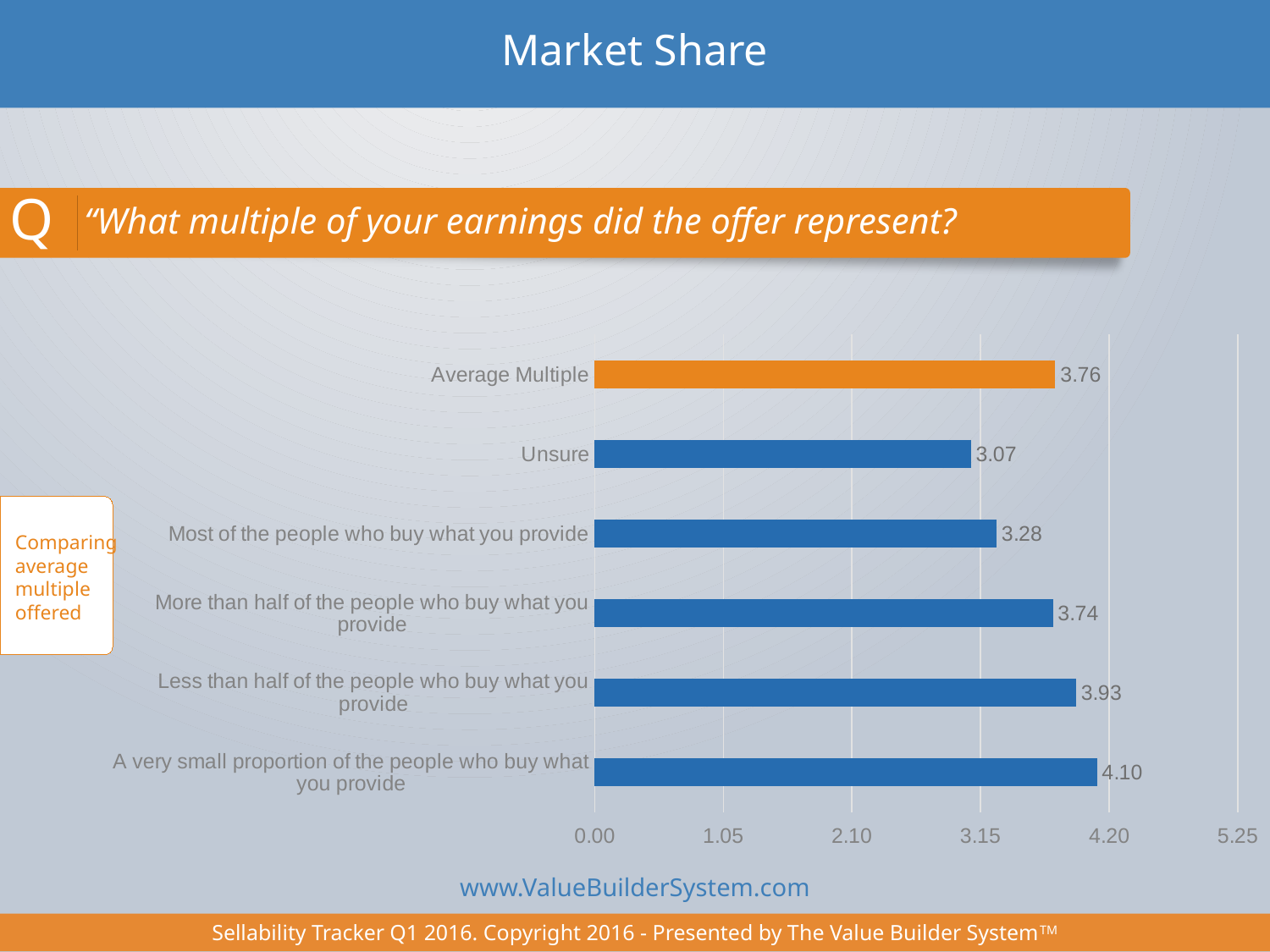
Which is larger: the value for 'Most of the people who buy what you provide' or 'More than half of the people who buy what you provide'? More than half of the people who buy what you provide What is the value for 'A very small proportion of the people who buy what you provide'? 4.10 How many categories are shown in the chart? 6 Which category has the lowest value? Unsure What kind of chart is shown on the slide? bar chart What is the value for 'Less than half of the people who buy what you provide'? 3.93 Which category has the highest value? A very small proportion of the people who buy what you provide What is the difference between the values for 'A very small proportion of the people who buy what you provide' and 'Unsure'? 1.03 What is the value for 'Average Multiple'? 3.76 What is the value for 'Unsure'? 3.07 Which bar is coloured orange rather than blue? Average Multiple Is the value for 'Unsure' greater or less than 3.15? less